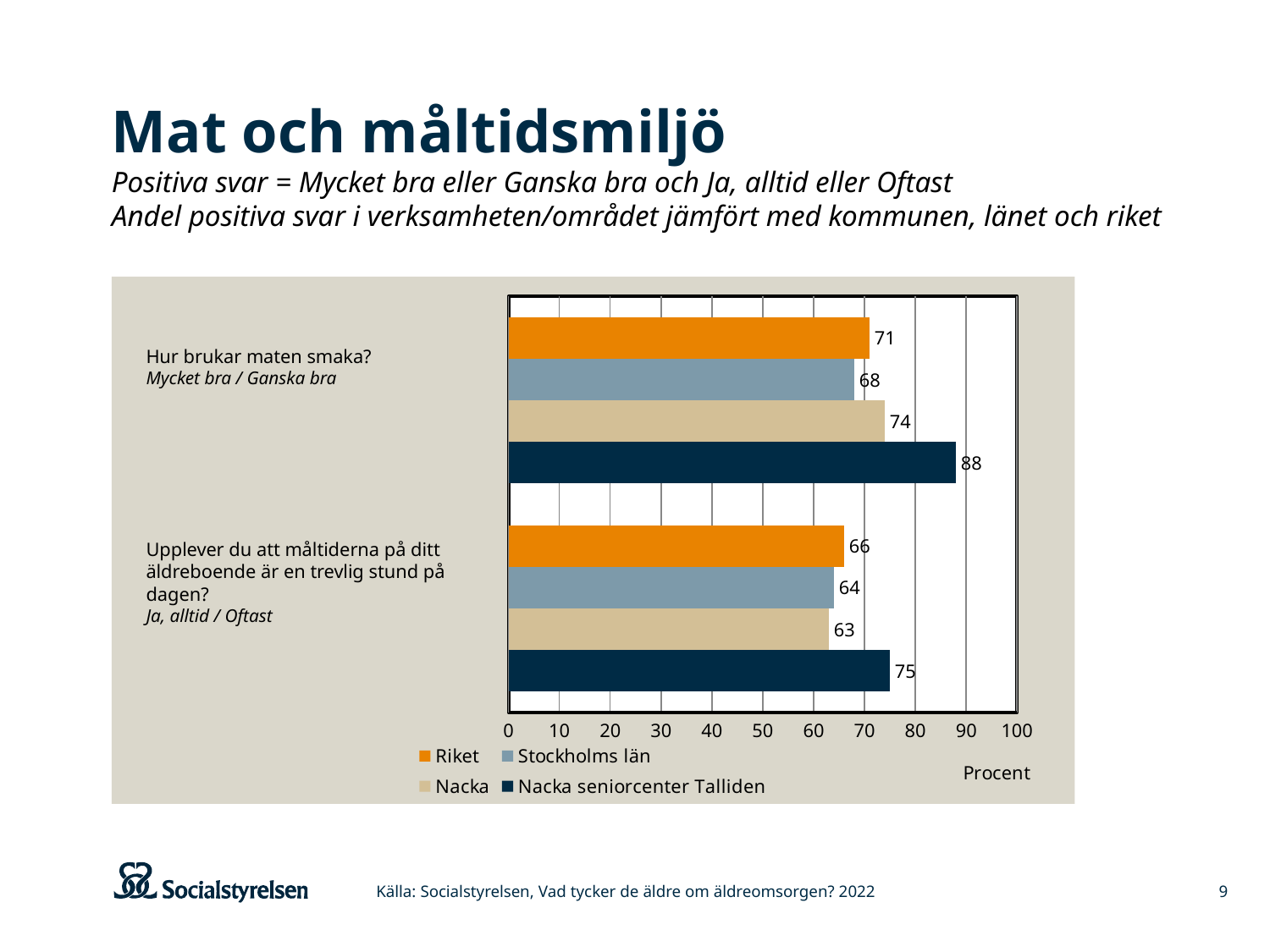
For the question "Hur brukar maten smaka?", which is larger: the value for Nacka or the value for Stockholms län? Nacka Which series has the highest value for the question "Hur brukar maten smaka?"? Nacka seniorcenter Talliden What is the label of the horizontal axis? Procent How many series does the legend list? 4 What is the value for Nacka seniorcenter Talliden for the question "Hur brukar maten smaka?"? 88 Which series has the lowest value for the question "Upplever du att måltiderna på ditt äldreboende är en trevlig stund på dagen?"? Nacka What is the difference between Nacka seniorcenter Talliden and Nacka for the question "Hur brukar maten smaka?"? 14 What kind of chart is shown on the slide? Bar chart What is the difference between Riket and Stockholms län for the question "Upplever du att måltiderna på ditt äldreboende är en trevlig stund på dagen?"? 2 What is the value for Stockholms län for the question "Upplever du att måltiderna på ditt äldreboende är en trevlig stund på dagen?"? 64 How many questions (categories) are shown on the chart? 2 What is the value for Riket for the question "Hur brukar maten smaka?"? 71